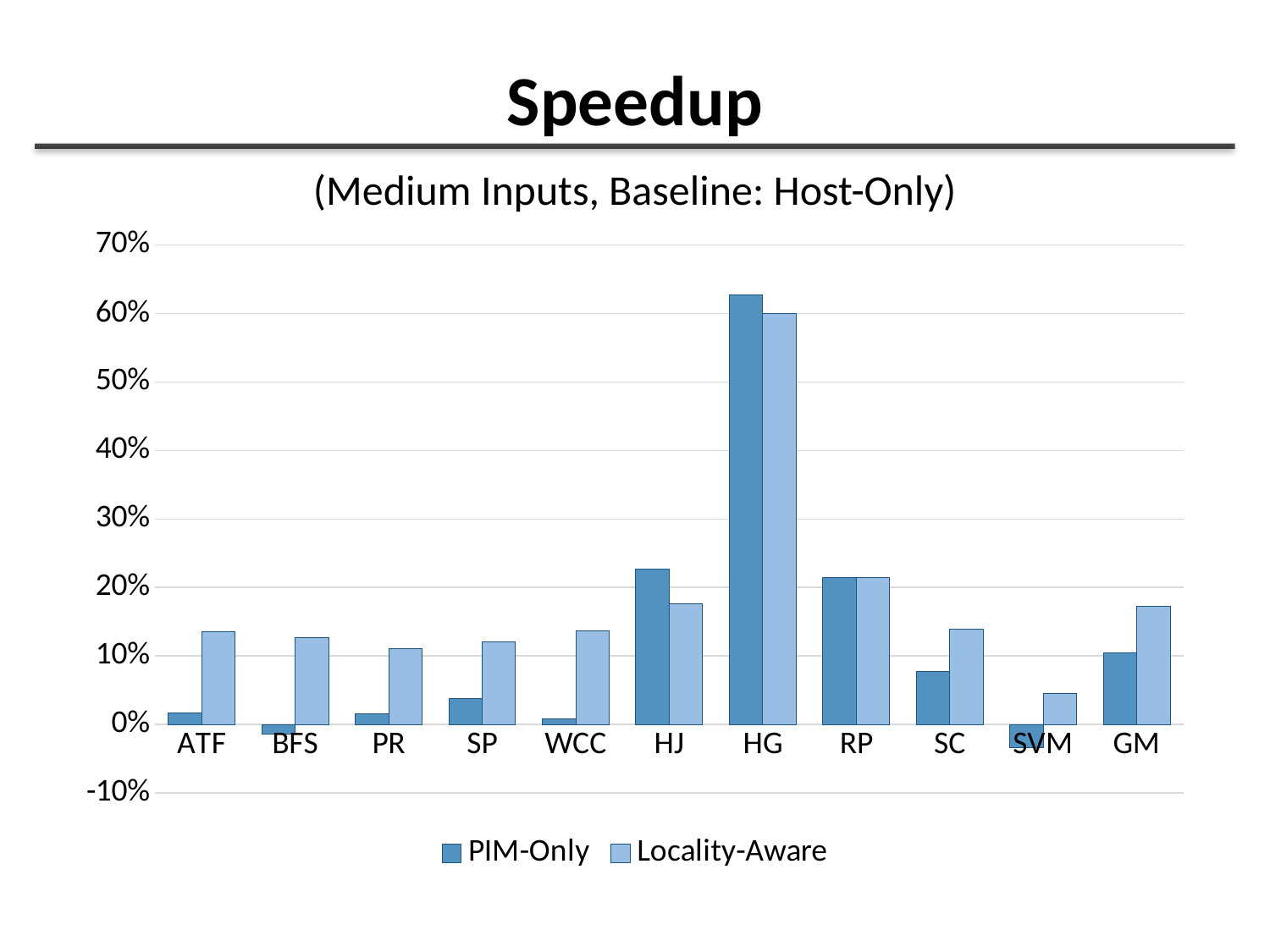
Which category has the lowest Locality-Aware speedup? SVM What kind of chart is shown on the slide? bar chart Which category has the lowest PIM-Only speedup? SVM Is the PIM-Only value for HG greater or less than 60%? greater Which category has the highest Locality-Aware speedup? HG Is the PIM-Only value for SVM greater or less than 0%? less For HJ, which series has the larger speedup, PIM-Only or Locality-Aware? PIM-Only Which category has the highest PIM-Only speedup? HG How many categories are shown on the x axis? 11 What is the subtitle shown above the chart? (Medium Inputs, Baseline: Host-Only) How many series does the legend list? 2 For GM, which series has the larger speedup, PIM-Only or Locality-Aware? Locality-Aware